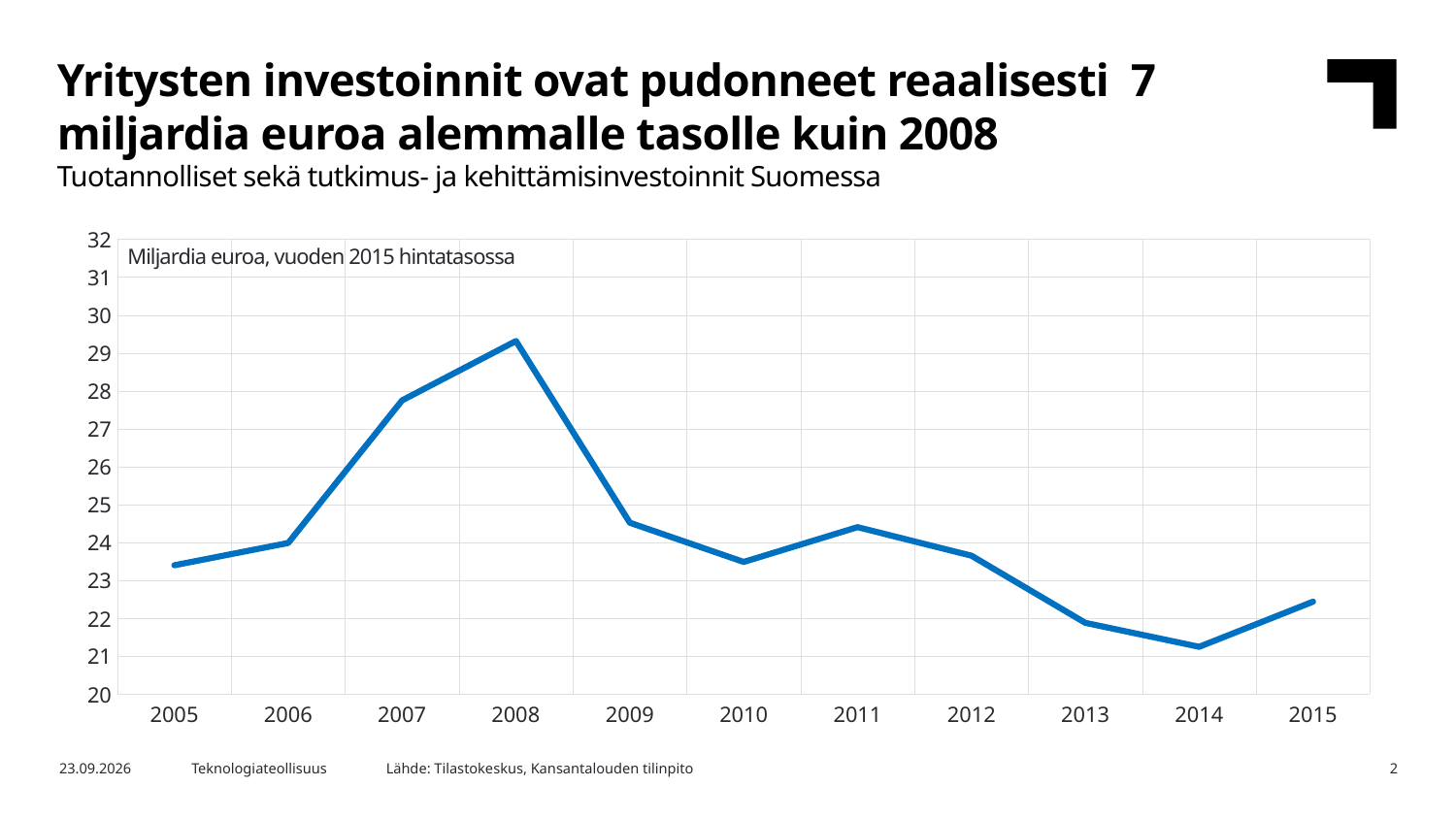
What kind of chart is shown on the slide? Line chart Do the values rise or fall from 2008 to 2010? Fall Is the value for 2014 greater or less than 22? less Is the value for 2008 greater or less than 28? greater How many years are plotted on the x axis? 11 Is the value for 2007 greater or less than 27? greater Which year has the lowest value on the chart? 2014 Which year has the larger value, 2007 or 2010? 2007 Which year has the highest value on the chart? 2008 What unit label is shown inside the chart area? Miljardia euroa, vuoden 2015 hintatasossa Which year has the larger value, 2006 or 2013? 2006